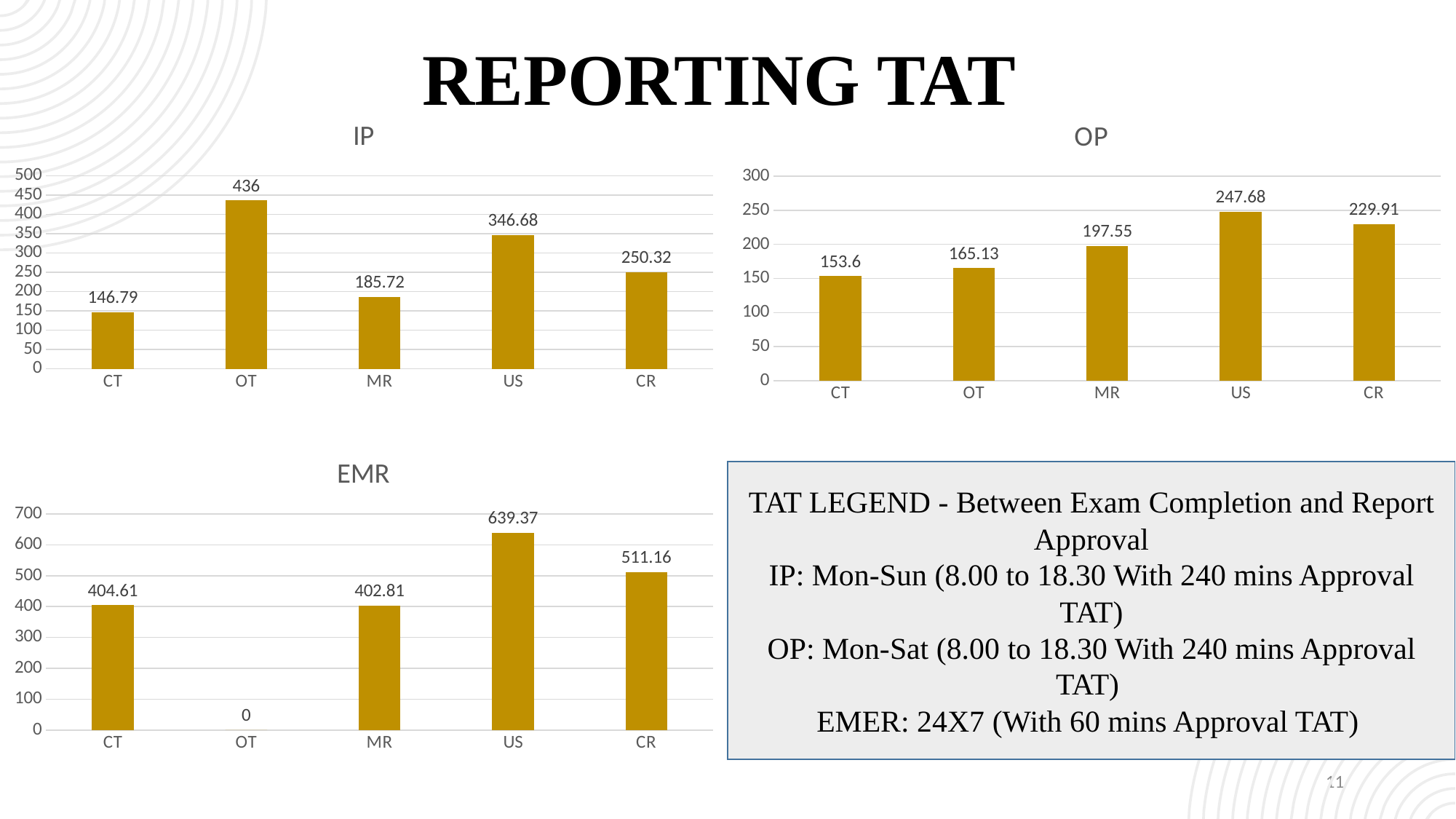
In the OP chart, which category has the highest value? US In the OP chart, what is the value for MR? 197.55 In the OP chart, what is the difference between the values for US and CR? 17.77 What is the title of the chart in the top right of the slide? OP In the IP chart, which category has the lowest value? CT In the IP chart, what is the difference between the values for OT and CT? 289.21 In the EMR chart, what is the value for US? 639.37 In the IP chart, what is the value for OT? 436 In the EMR chart, which is larger, the value for CR or the value for MR? CR What kind of chart is the EMR chart? bar chart In the EMR chart, which category has the lowest value? OT How many categories are shown in the OP chart? 5